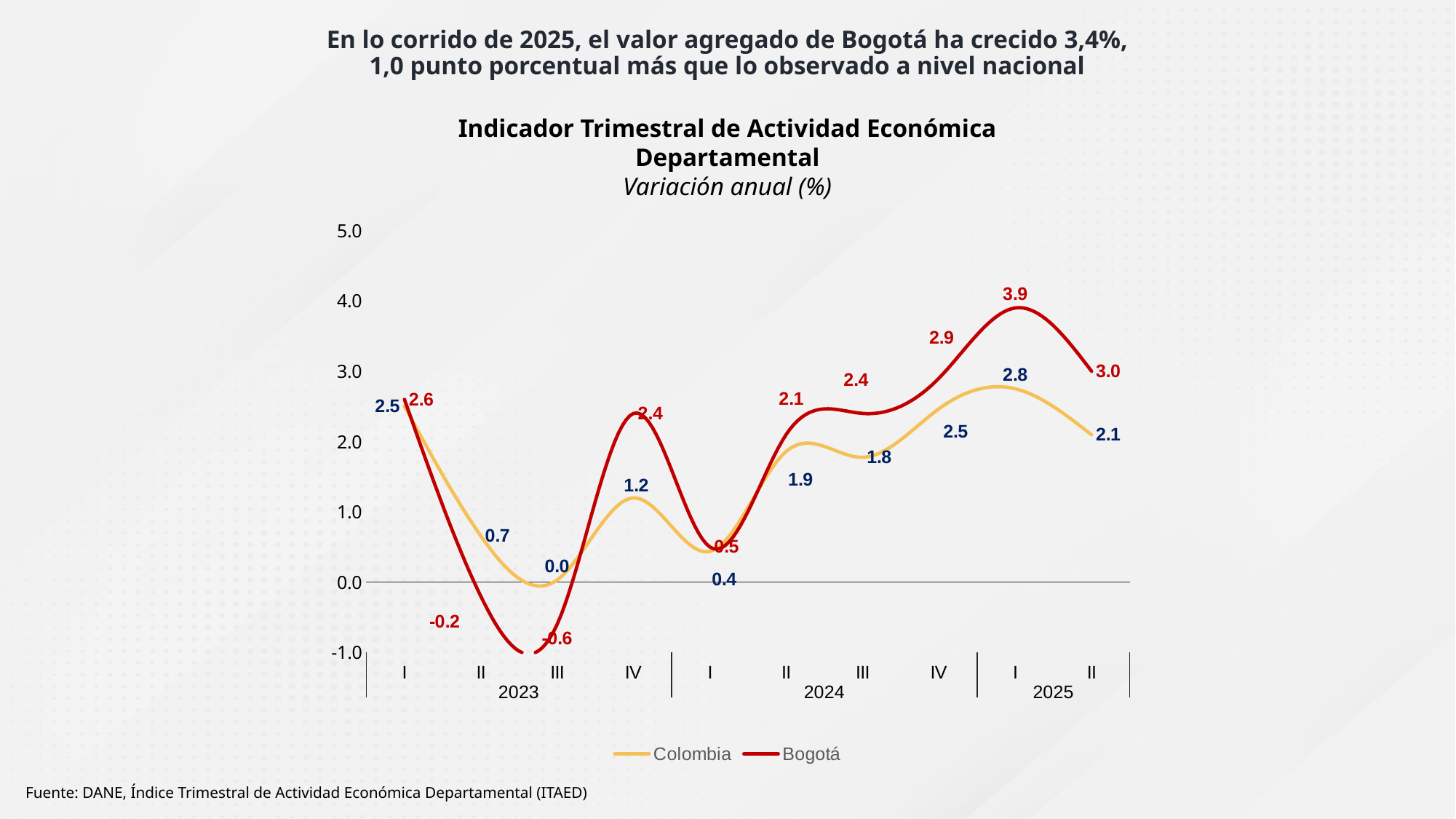
How many quarterly data points are plotted for each series? 10 In which quarter does the Colombia series reach its highest value? I 2025 What is the difference between the Bogotá and Colombia values in quarter I of 2025? 1.1 What is the value for Colombia in quarter III of 2023? 0.0 What is the value for Bogotá in quarter I of 2025? 3.9 In quarter IV of 2024, which series has the larger value, Colombia or Bogotá? Bogotá Does the Bogotá series rise or fall from quarter I of 2024 to quarter I of 2025? Rise What is the value for Colombia in quarter II of 2025? 2.1 What kind of chart is shown on the slide? Line chart In which quarter does the Bogotá series reach its highest value? I 2025 In which quarter does the Bogotá series reach its lowest value? III 2023 How many series does the legend list? 2